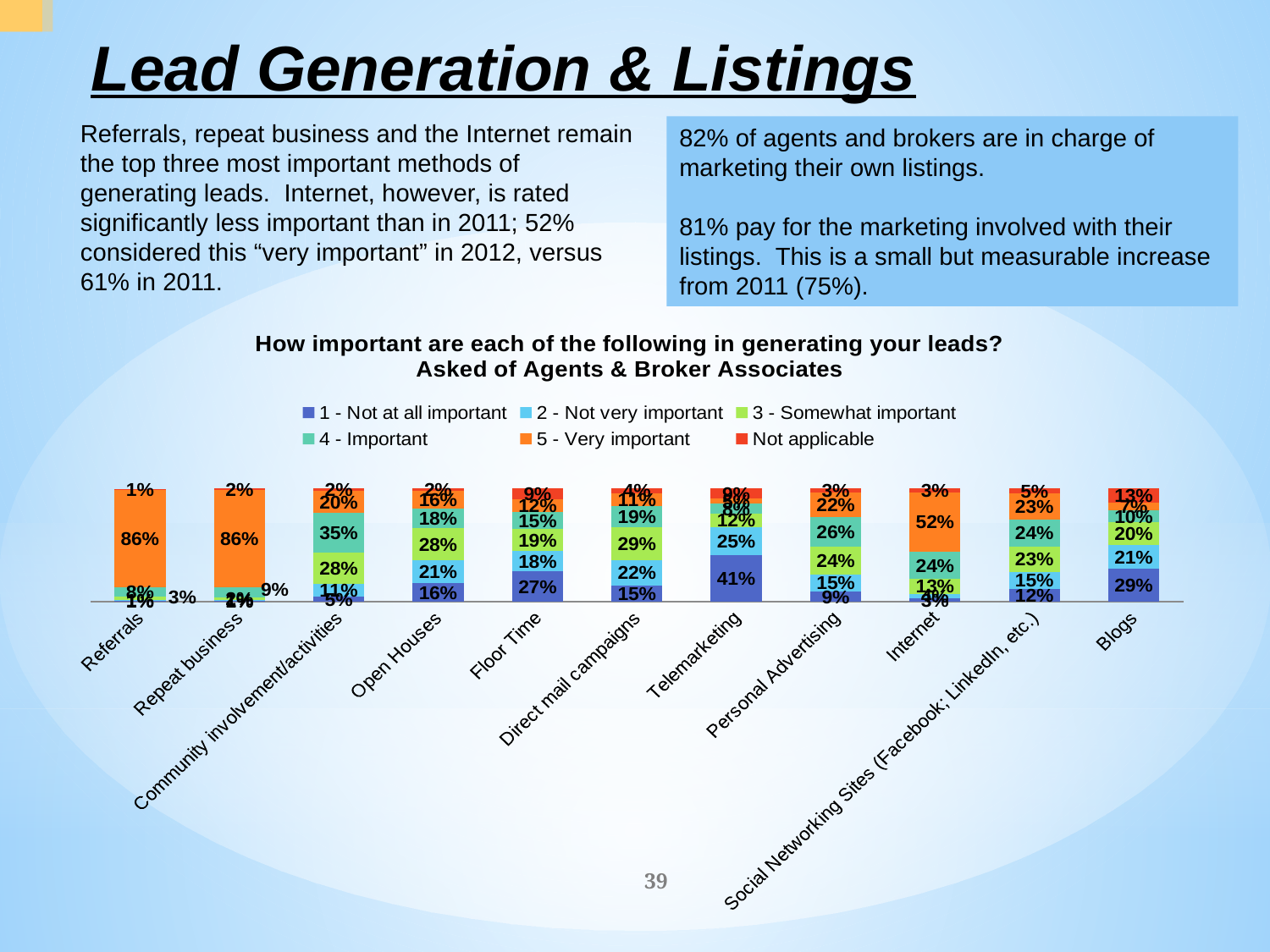
What percentage rated Blogs as "1 - Not at all important"? 29% How many response categories does the chart's legend list? 6 What percentage rated Community involvement/activities as "4 - Important"? 35% What type of chart is used to show the importance of lead-generation methods? Stacked bar chart How many lead-generation methods are shown on the x axis of the chart? 11 Which group of respondents was the chart's question asked of? Agents & Broker Associates How many percentage points higher is the "5 - Very important" share for Internet than for Personal Advertising? 30 percentage points Which has a larger "1 - Not at all important" share: Open Houses or Floor Time? Floor Time Which lead-generation method has the highest share of "1 - Not at all important" responses? Telemarketing What percentage rated the Internet as "5 - Very important" in generating leads? 52% What percentage of agents and broker associates rated Referrals as "5 - Very important" for generating leads? 86% What percentage rated Telemarketing as "1 - Not at all important"? 41%